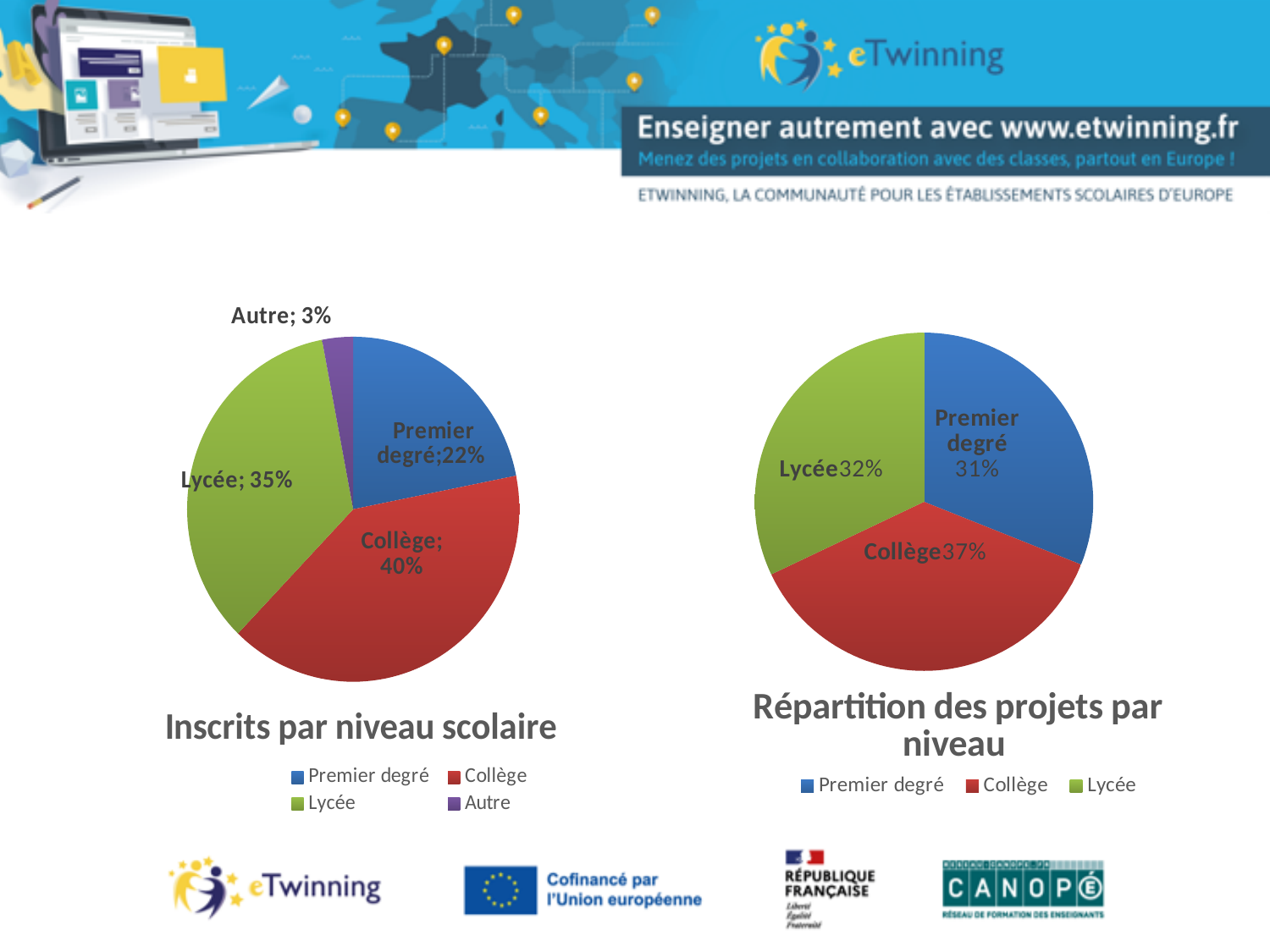
In the 'Inscrits par niveau scolaire' chart, what colour represents Lycée? Green In the 'Inscrits par niveau scolaire' chart, how many categories are shown? 4 In the 'Inscrits par niveau scolaire' chart, which category has the smallest share? Autre In the 'Répartition des projets par niveau' chart, what percentage is shown for Lycée? 32% In the 'Inscrits par niveau scolaire' chart, what percentage is shown for Collège? 40% In the 'Inscrits par niveau scolaire' chart, which category has the largest share? Collège What type of chart is 'Répartition des projets par niveau'? Pie chart In the 'Inscrits par niveau scolaire' chart, what is the difference in percentage points between Lycée and Premier degré? 13 In the 'Répartition des projets par niveau' chart, how many categories does the legend list? 3 In the 'Inscrits par niveau scolaire' chart, what percentage is shown for Autre? 3% In the 'Répartition des projets par niveau' chart, what percentage is shown for Premier degré? 31% In the 'Répartition des projets par niveau' chart, which category has the largest share? Collège